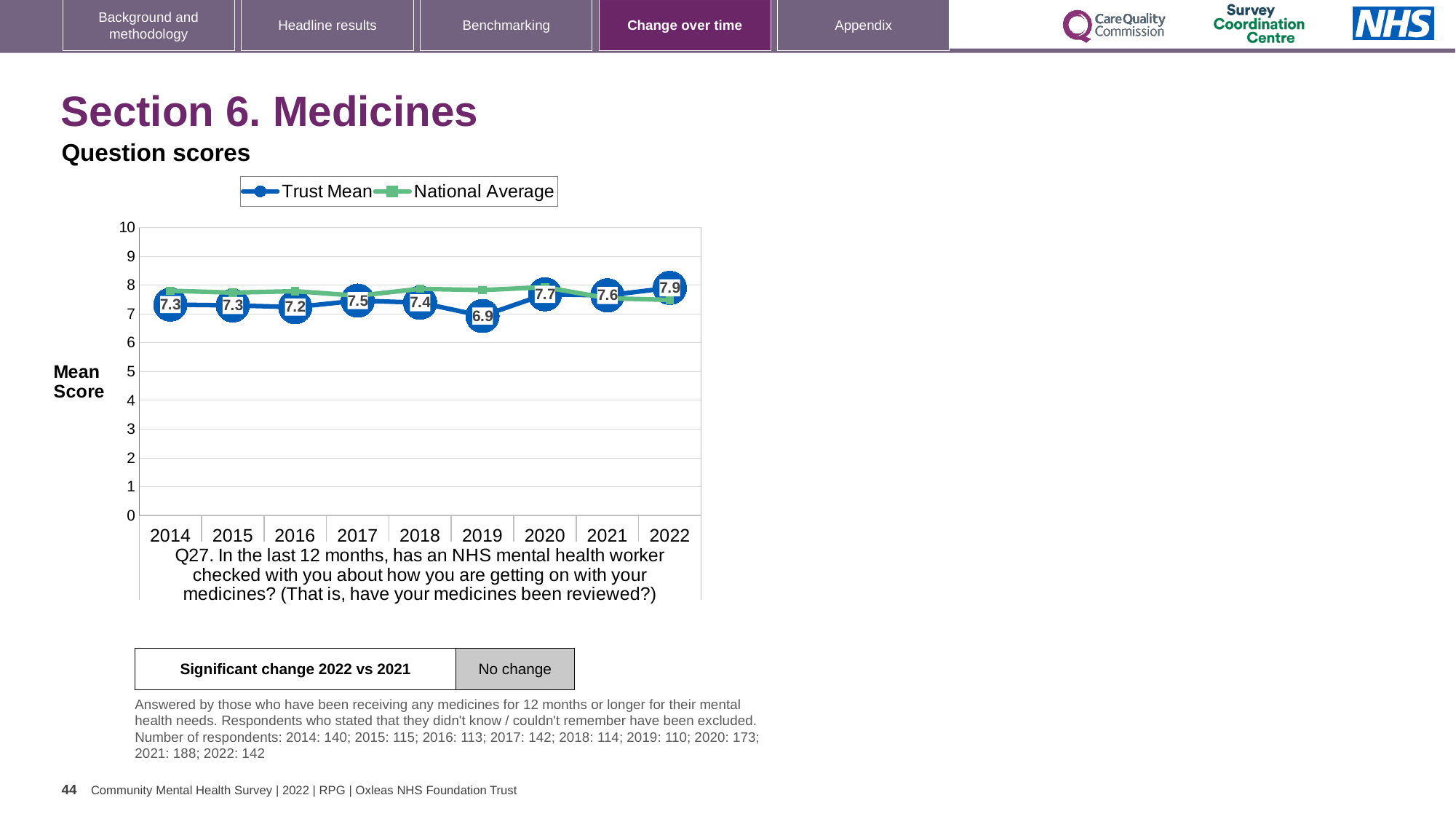
In which year is the Trust Mean score lowest? 2019 Which is larger, the Trust Mean score for 2020 or for 2021? 2020 What is the Trust Mean score for 2019? 6.9 What is the Trust Mean score for 2017? 7.5 What kind of chart is shown on the slide? Line chart What is the label on the y axis of the chart? Mean Score How many series does the chart legend list? 2 What is the difference between the Trust Mean scores for 2022 and 2019? 1.0 In which year is the Trust Mean score highest? 2022 How many years are shown on the x axis of the chart? 9 What is the Trust Mean score for 2022? 7.9 Is the National Average value for 2019 greater or less than 7? greater